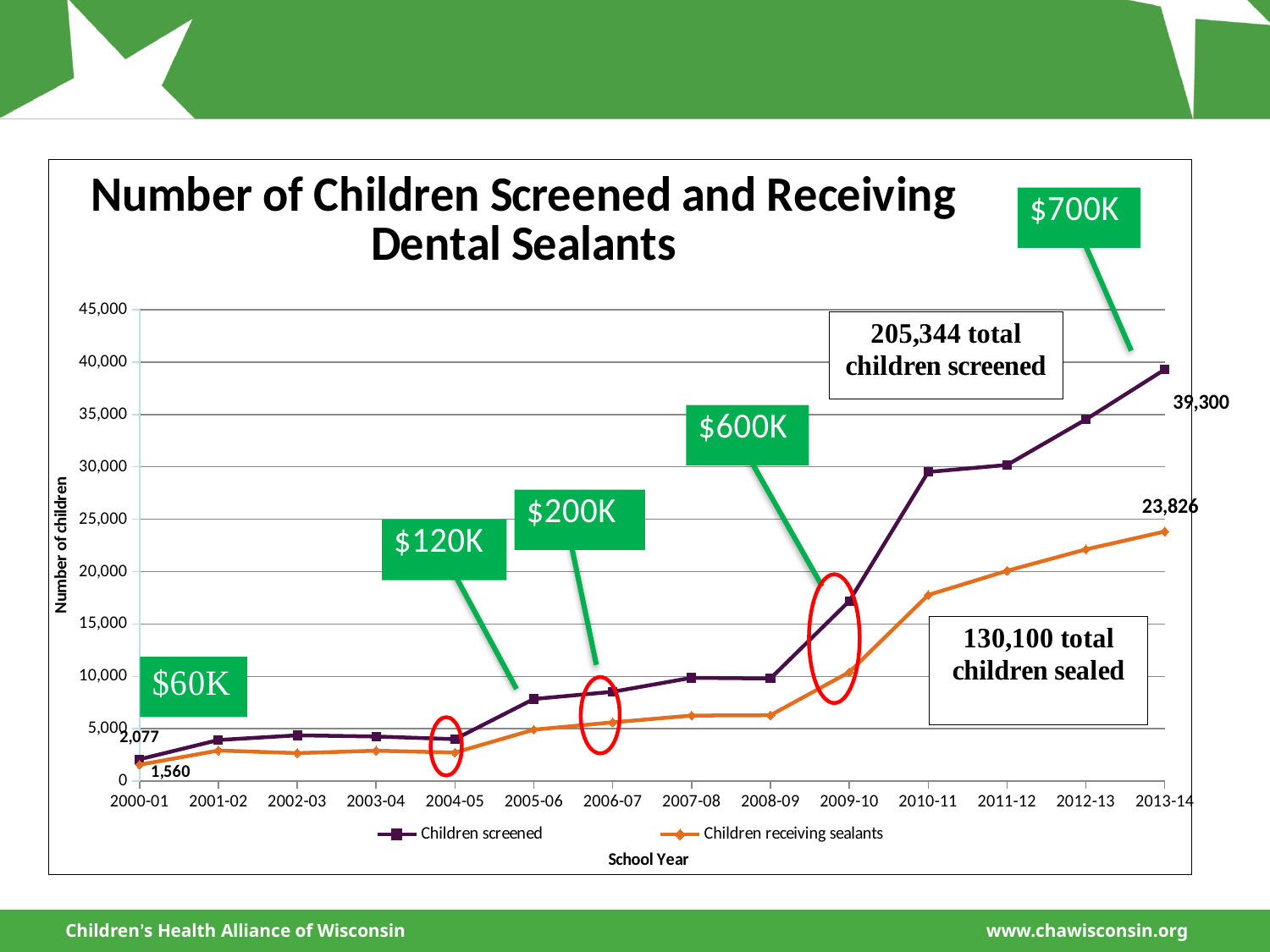
How many series does the legend list? 2 What is the difference between Children screened and Children receiving sealants in 2013-14? 15,474 What is the value for Children receiving sealants in 2000-01? 1,560 Is the value for Children screened in 2010-11 greater or less than 25,000? greater What is the difference between Children screened and Children receiving sealants in 2000-01? 517 What kind of chart is shown on the slide? line chart How many school years are plotted along the x axis? 14 Do the values for Children screened rise or fall from 2000-01 to 2013-14? rise What is the value for Children receiving sealants in 2013-14? 23,826 What is the value for Children screened in 2000-01? 2,077 In which school year is the value for Children screened highest? 2013-14 What is the value for Children screened in 2013-14? 39,300